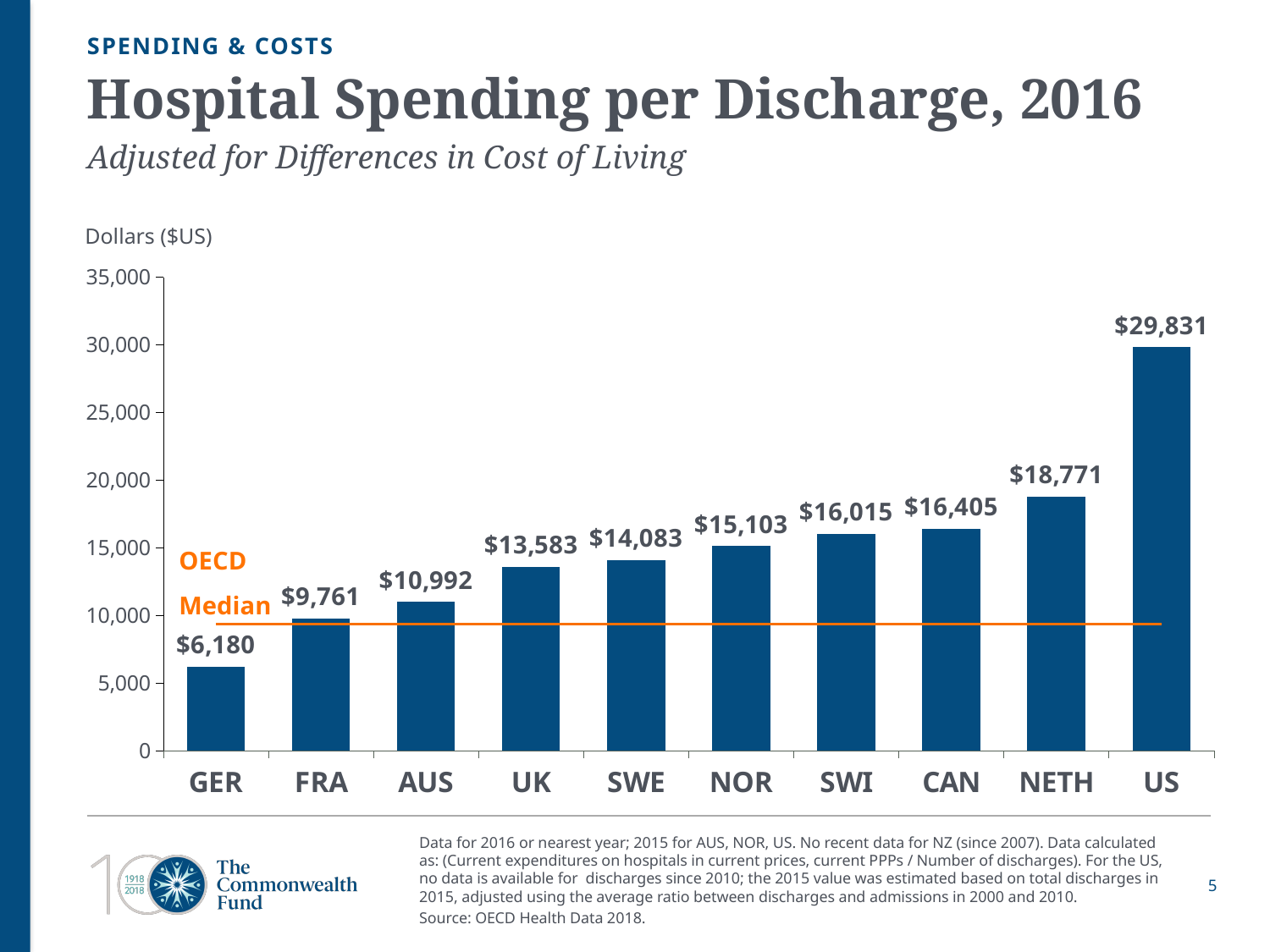
Which country has the lowest hospital spending per discharge? GER What is the difference in hospital spending per discharge between Canada (CAN) and Switzerland (SWI)? $390 What is the difference in hospital spending per discharge between the US and the Netherlands (NETH)? $11,060 What is the hospital spending per discharge for the US? $29,831 Which country has the highest hospital spending per discharge? US What is the hospital spending per discharge for Germany (GER)? $6,180 Which has higher hospital spending per discharge, the UK or Norway (NOR)? NOR Is the OECD median line greater or less than 10,000? less What is the hospital spending per discharge for Sweden (SWE)? $14,083 Do the values rise or fall moving from left to right along the x axis? Rise How many countries are shown in the chart? 10 What kind of chart is shown on the slide? Bar chart